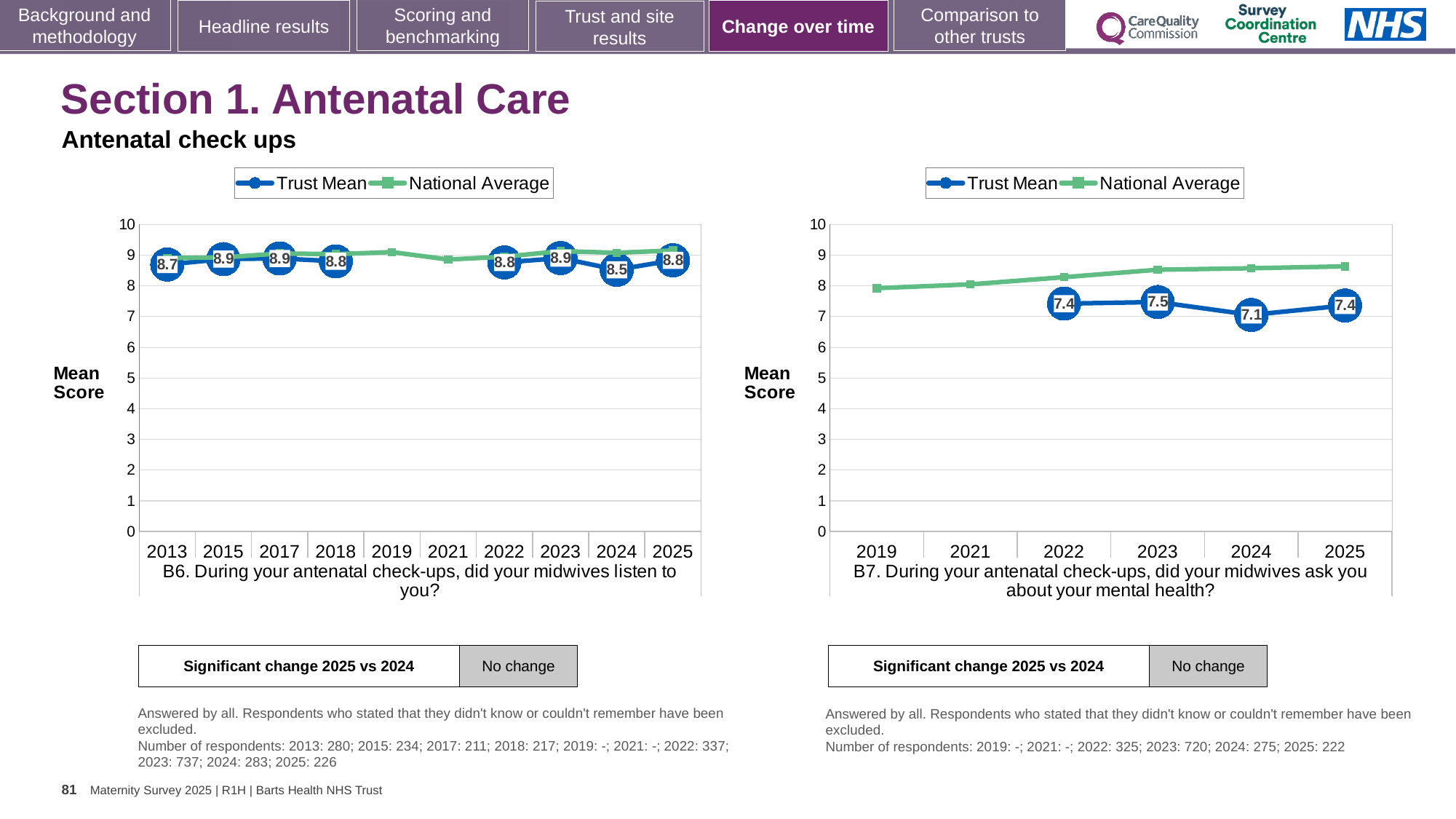
How many series does the legend of the B7 chart on the right list? 2 What are the two legend entries in the B6 chart on the left? Trust Mean and National Average In the B6 chart on the left, what is the Trust Mean for 2024? 8.5 In the B7 chart on the right, does the National Average rise or fall from 2019 to 2025? Rise How many years are shown on the x axis of the B6 chart on the left? 10 In the B6 chart on the left, which year has the lowest Trust Mean? 2024 In the B7 chart on the right, what is the difference between the Trust Mean for 2023 and 2024? 0.4 In the B7 chart on the right, which year has the lowest Trust Mean? 2024 In the B7 chart on the right, is the National Average for 2025 greater or less than 8? greater In the B7 chart on the right, what is the Trust Mean for 2023? 7.5 What kind of chart is the B6 chart on the left? Line chart In the B6 chart on the left, is the Trust Mean higher in 2013 or 2015? 2015